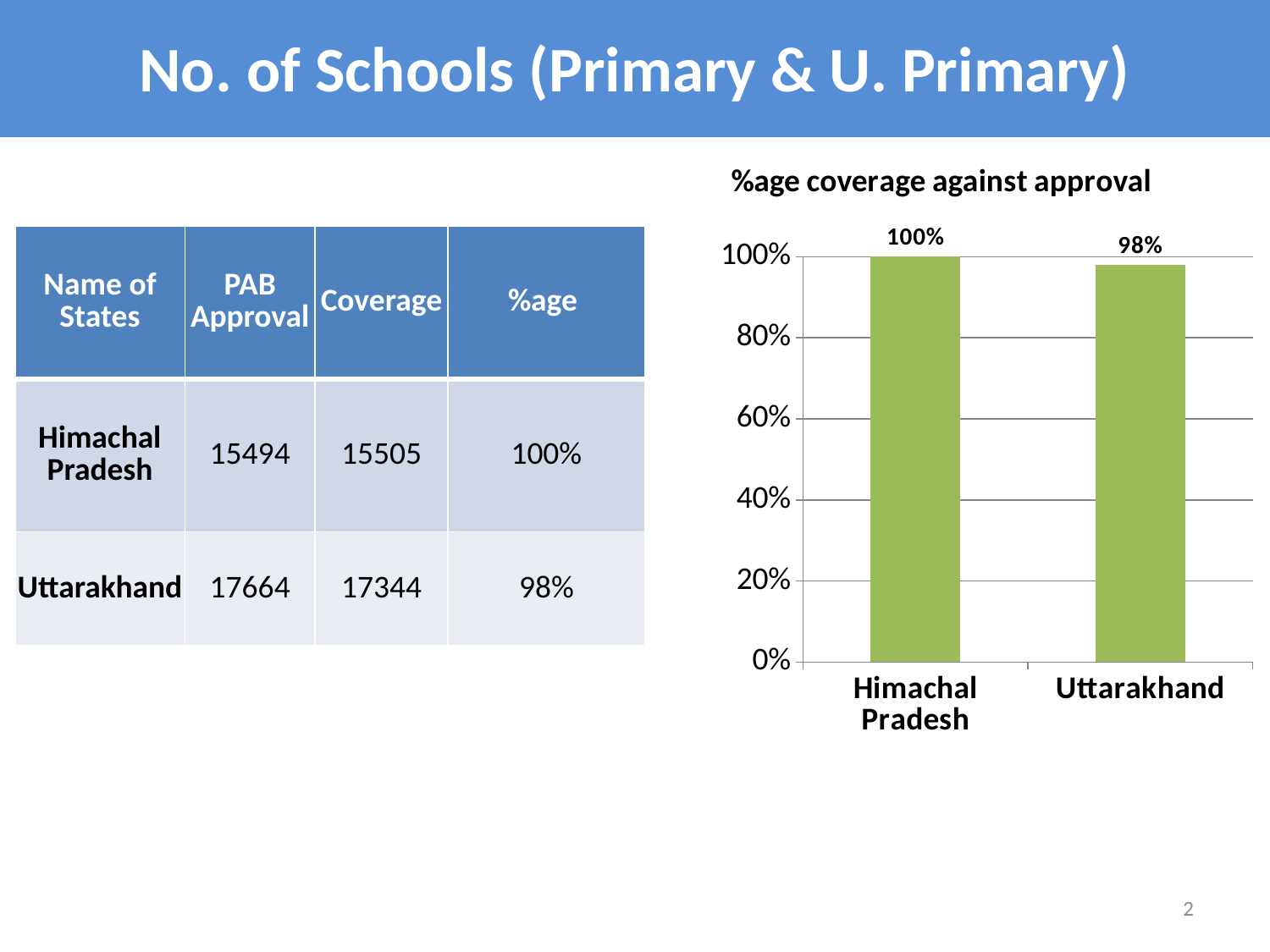
What colour are the bars in the chart? Green Do the values rise or fall from Himachal Pradesh to Uttarakhand along the x axis? Fall What is the %age coverage against approval for Himachal Pradesh? 100% Which state has the lowest %age coverage against approval in the chart? Uttarakhand What is the difference in %age coverage between Himachal Pradesh and Uttarakhand? 2% What is the %age coverage against approval for Uttarakhand? 98% Is the value for Uttarakhand greater or less than 80%? greater How many states are shown in the chart? 2 What kind of chart is shown on the slide? Bar chart What is the title of the chart? %age coverage against approval Which state has the highest %age coverage against approval in the chart? Himachal Pradesh Which state has a higher %age coverage against approval, Himachal Pradesh or Uttarakhand? Himachal Pradesh